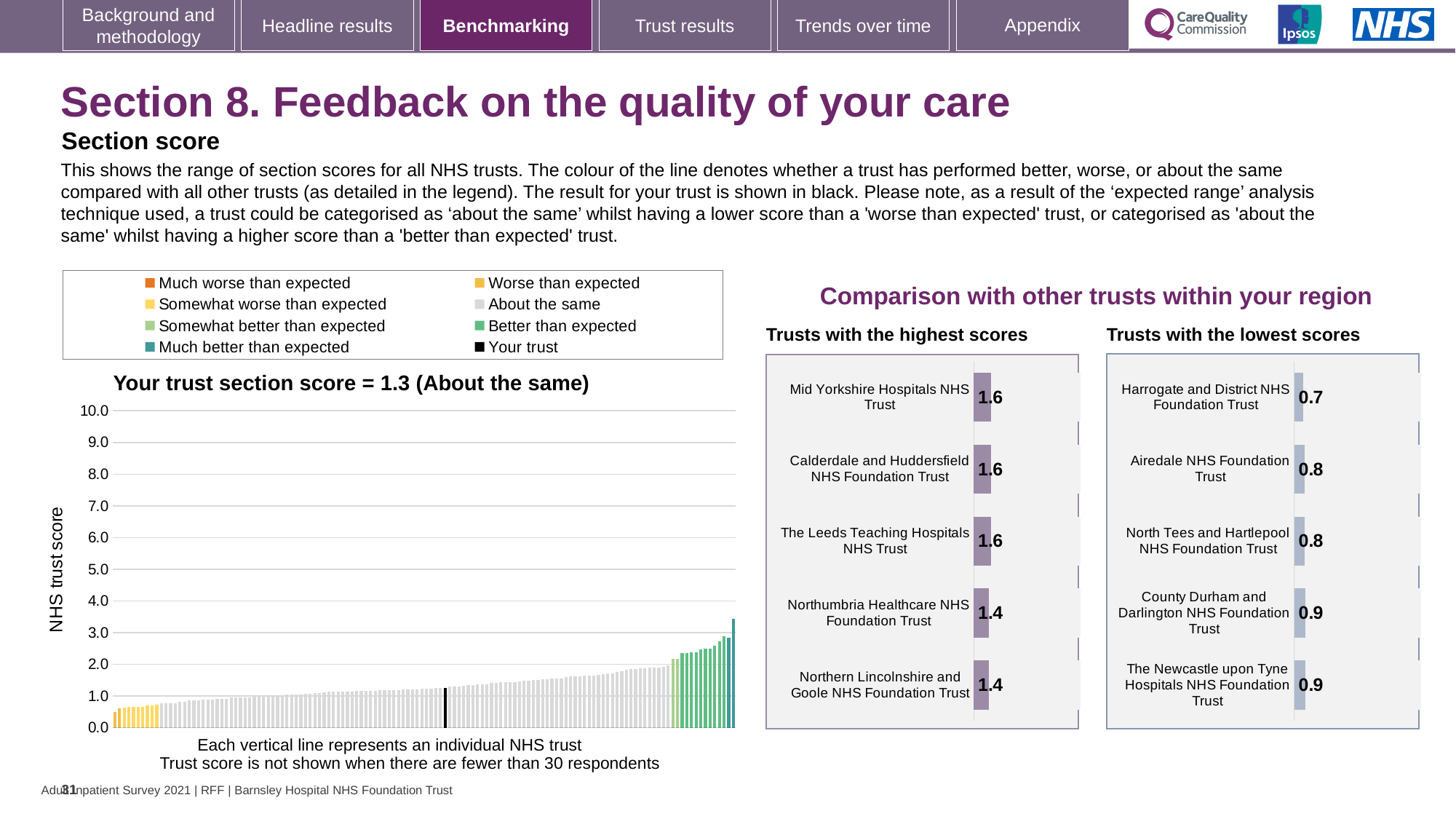
In the main 'Your trust section score' chart, what is the section score for your trust? 1.3 In the 'Trusts with the highest scores' chart, what is the score for Northumbria Healthcare NHS Foundation Trust? 1.4 What kind of chart is the main 'Your trust section score' chart? bar chart In the 'Trusts with the lowest scores' chart, what is the score for Harrogate and District NHS Foundation Trust? 0.7 In the 'Trusts with the lowest scores' chart, which trust has the lowest score? Harrogate and District NHS Foundation Trust How many trusts are listed in the 'Trusts with the lowest scores' chart? 5 In the 'Trusts with the highest scores' chart, what is the score for Mid Yorkshire Hospitals NHS Trust? 1.6 How many entries does the legend above the main 'Your trust section score' chart list? 8 In the 'Trusts with the lowest scores' chart, what is the score for County Durham and Darlington NHS Foundation Trust? 0.9 In the 'Trusts with the lowest scores' chart, what is the difference between the scores of The Newcastle upon Tyne Hospitals NHS Foundation Trust and Harrogate and District NHS Foundation Trust? 0.2 In the 'Trusts with the highest scores' chart, what is the difference between the scores of Mid Yorkshire Hospitals NHS Trust and Northern Lincolnshire and Goole NHS Foundation Trust? 0.2 In the main 'Your trust section score' chart, is the value of the tallest bar greater or less than 3.0? greater